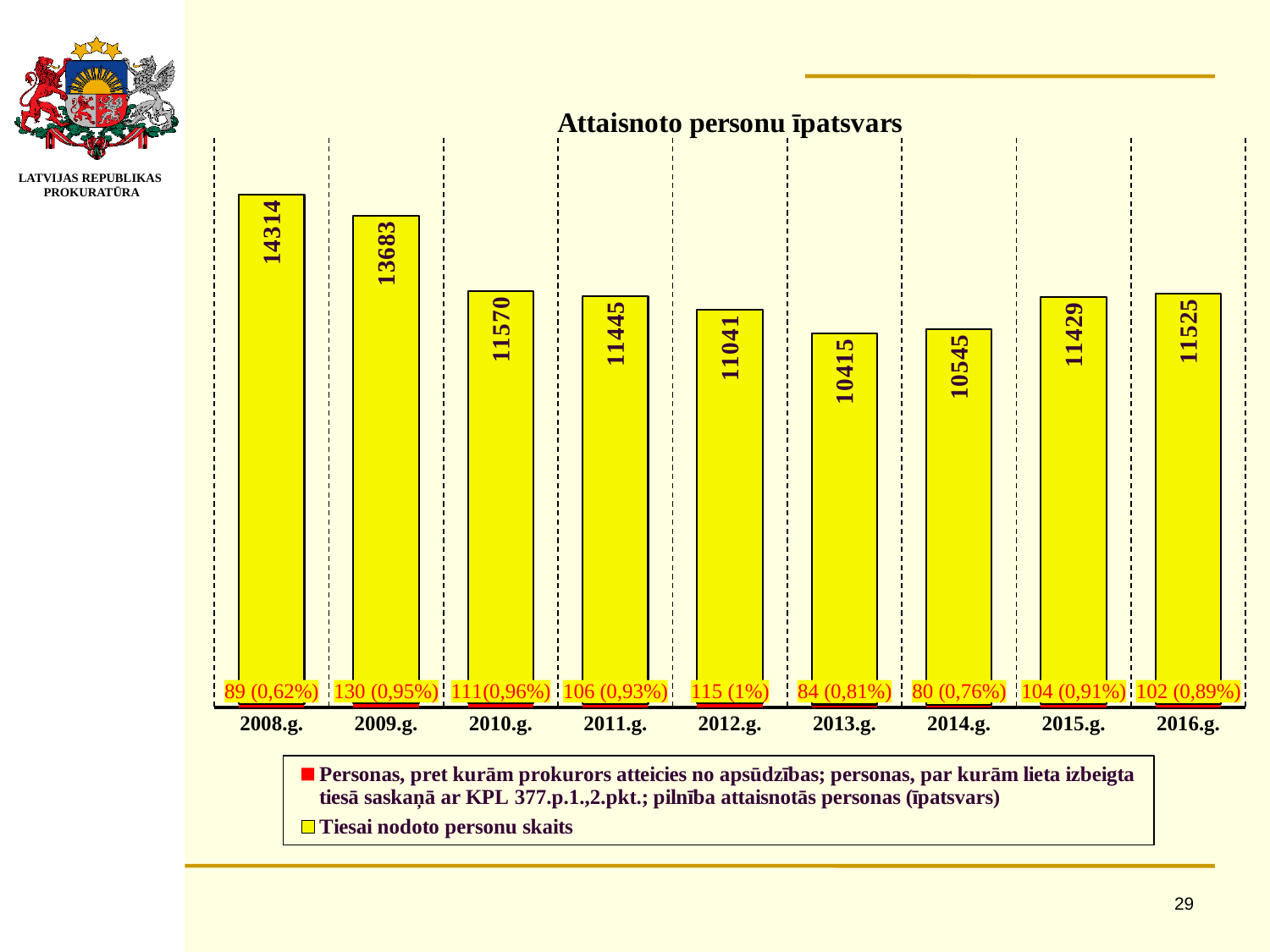
What is the value of "Tiesai nodoto personu skaits" for 2013.g.? 10415 Which is larger, the "Tiesai nodoto personu skaits" value for 2010.g. or for 2016.g.? 2010.g. How many series does the legend list? 2 Which year has the highest value of "Tiesai nodoto personu skaits"? 2008.g. What is the value of "Tiesai nodoto personu skaits" for 2008.g.? 14314 What kind of chart is shown on the slide? bar chart What label is shown for the red series in 2009.g.? 130 (0,95%) Which year has the lowest value of "Tiesai nodoto personu skaits"? 2013.g. What is the difference between the "Tiesai nodoto personu skaits" values for 2008.g. and 2009.g.? 631 What is the title of the chart? Attaisnoto personu īpatsvars What label is shown for the red series in 2012.g.? 115 (1%) How many years are shown on the x axis? 9